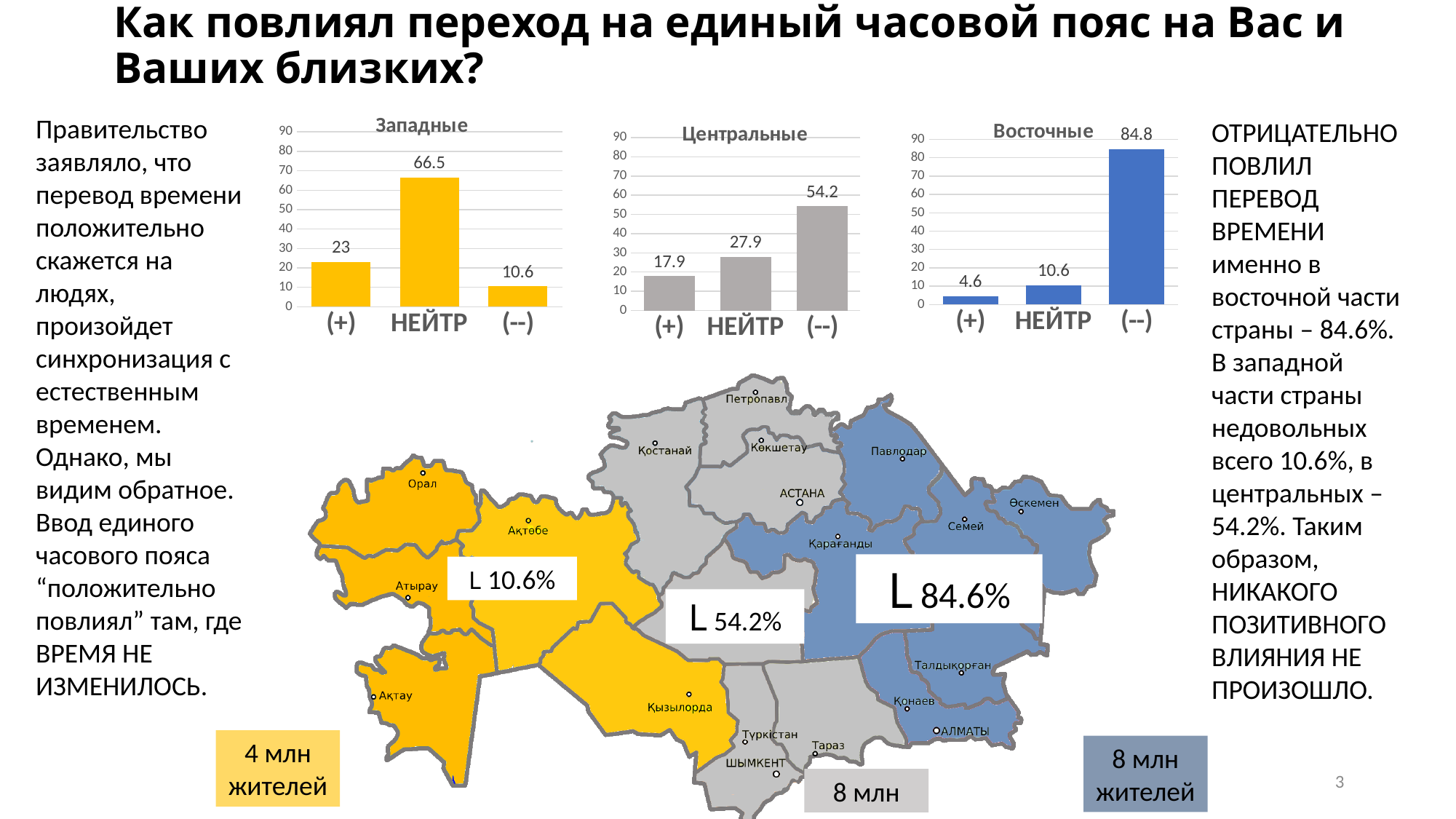
In the chart titled "Западные", which category has the lowest value? (--) In the chart titled "Западные", which is larger, the value for (+) or the value for (--)? (+) In the chart titled "Восточные", which category has the highest value? (--) In the chart titled "Восточные", what is the value for (+)? 4.6 In the chart titled "Восточные", do the values rise or fall from (+) to (--)? rise In the chart titled "Восточные", is the value for (--) greater or less than 80? greater In the chart titled "Центральные", what is the value for (--)? 54.2 What kind of chart is the chart titled "Западные"? bar chart How many categories are shown in the chart titled "Центральные"? 3 What colour are the bars in the chart titled "Восточные"? blue In the chart titled "Западные", what is the value for НЕЙТР? 66.5 In the chart titled "Центральные", what is the difference between the values for (--) and (+)? 36.3